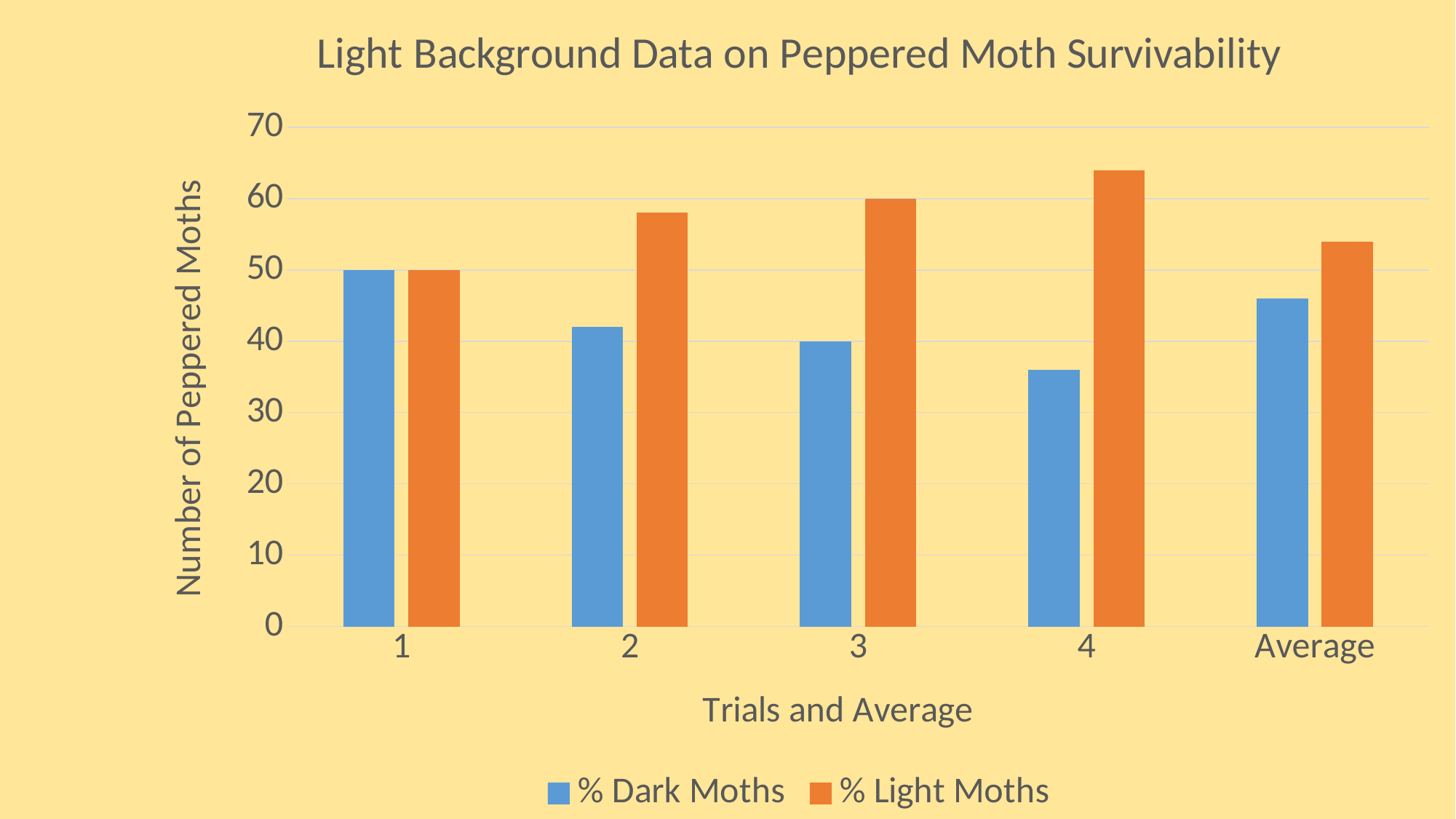
Is the value for % Light Moths in the Average category greater or less than 50? greater Which is larger in trial 2: % Dark Moths or % Light Moths? % Light Moths How many categories are shown on the x axis? 5 What type of chart is shown on the slide? bar chart Which category has the lowest value for % Dark Moths? 4 What is the value for % Dark Moths in trial 3? 40 Which category has the highest value for % Light Moths? 4 What is the value for % Dark Moths in trial 1? 50 How many series does the legend list? 2 Is the value for % Dark Moths in trial 4 greater or less than 40? less What is the value for % Light Moths in trial 3? 60 What is the difference between % Light Moths and % Dark Moths in trial 3? 20